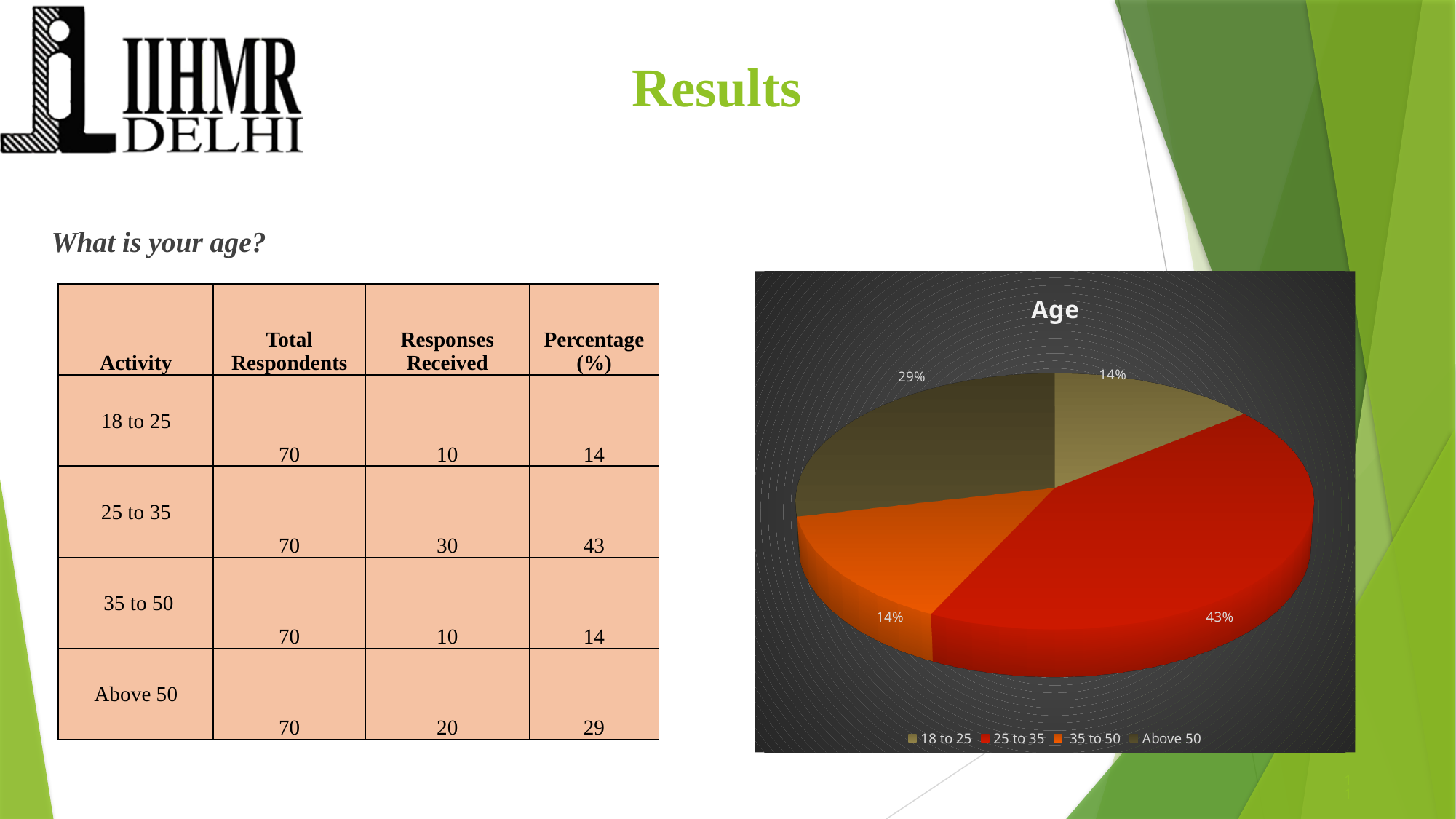
Which age group has the largest slice of the pie? 25 to 35 What percentage of the pie does the Above 50 slice represent? 29% What kind of chart is shown on the slide? pie chart How many entries does the legend of the pie chart list? 4 Which slice is larger, Above 50 or 18 to 25? Above 50 What is the title of the pie chart? Age What percentage of the pie does the 25 to 35 slice represent? 43% What percentage of the pie does the 35 to 50 slice represent? 14% How many slices does the pie chart have? 4 What percentage of the pie does the 18 to 25 slice represent? 14% What is the difference in percentage between the 25 to 35 slice and the Above 50 slice? 14% Which slice is larger, 25 to 35 or Above 50? 25 to 35